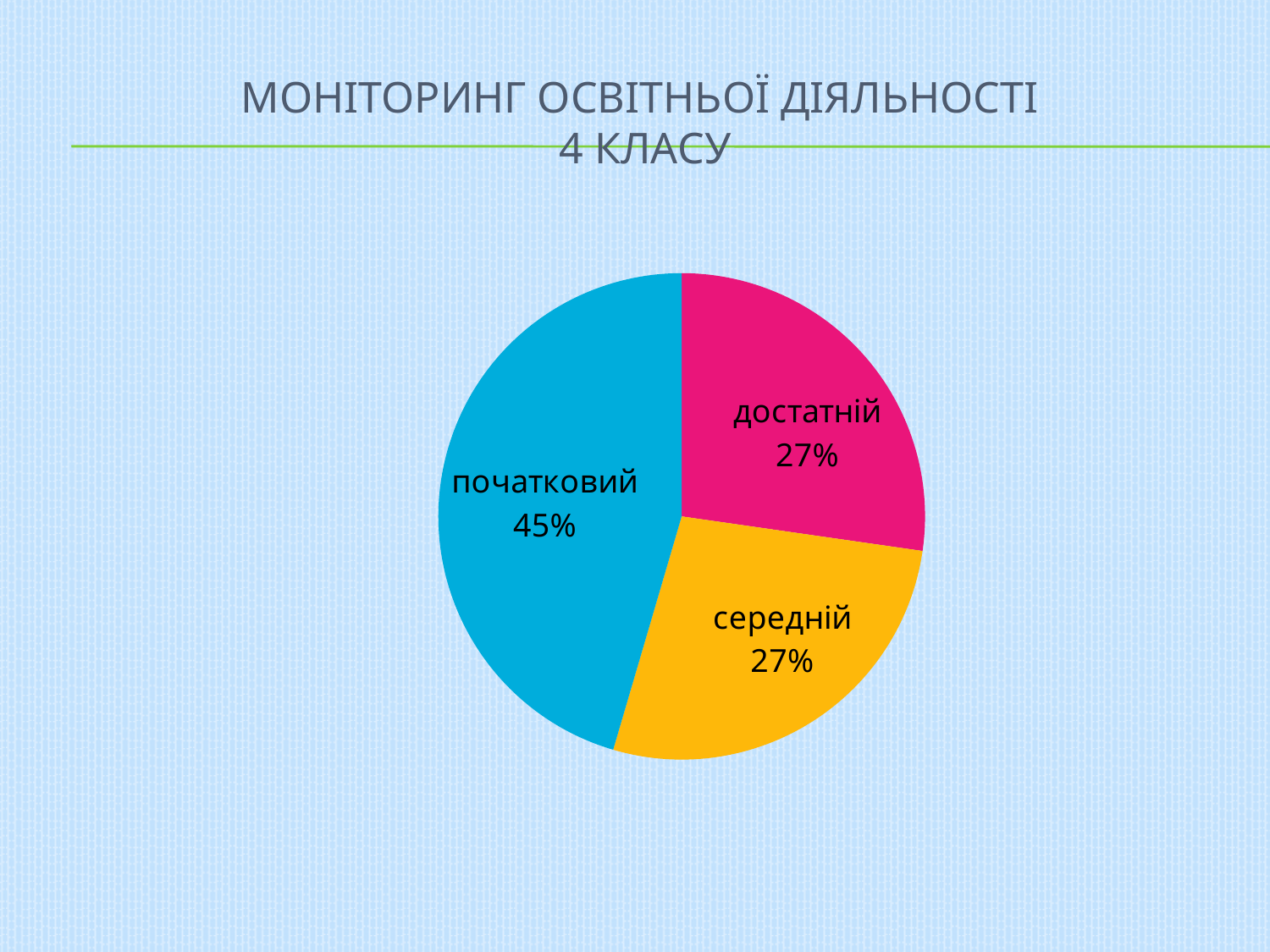
What share of the pie does the "середній" slice represent? 27% How many slices does the pie chart have? 3 Is the share for "початковий" greater or less than 50%? less What is the difference in percentage points between the "початковий" and "середній" slices? 18 What is the title of the slide? МОНІТОРИНГ ОСВІТНЬОЇ ДІЯЛЬНОСТІ 4 КЛАСУ Which category has the largest slice of the pie? початковий What kind of chart is shown on the slide? pie chart Which is larger, the "початковий" slice or the "достатній" slice? початковий What share of the pie does the "достатній" slice represent? 27% Do the "достатній" and "середній" slices have the same share? yes What colour is the "середній" slice? yellow What share of the pie does the "початковий" slice represent? 45%